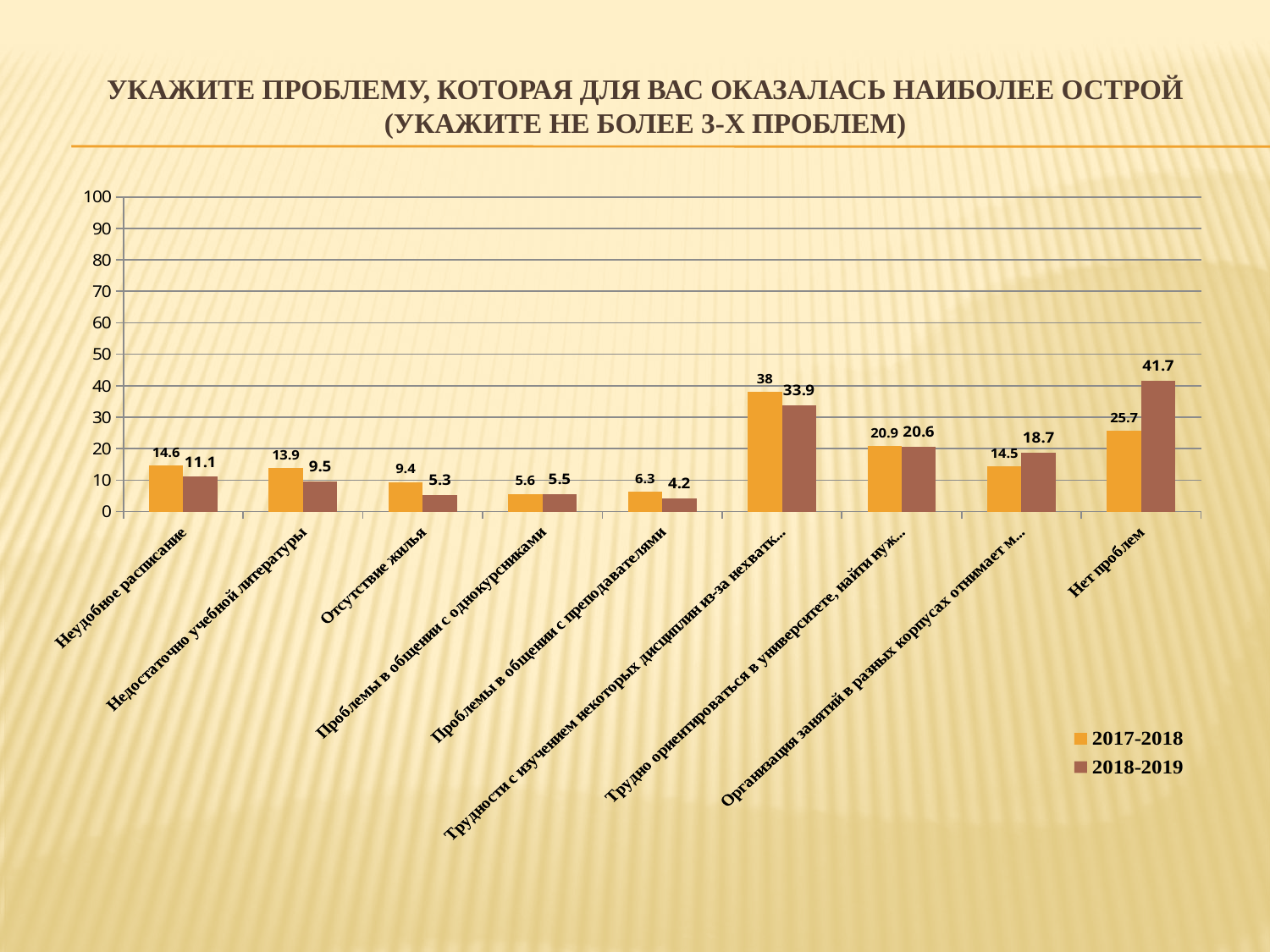
What is the difference between the 2017-2018 and 2018-2019 values for "Неудобное расписание"? 3.5 Which is larger for "Организация занятий в разных корпусах отнимает м...": the 2017-2018 value or the 2018-2019 value? 2018-2019 What is the difference between the 2018-2019 and 2017-2018 values for "Нет проблем"? 16 What kind of chart is shown on the slide? bar chart Which category has the lowest value in the 2018-2019 series? Проблемы в общении с преподавателями How many categories are shown on the x axis of the chart? 9 What is the value for "Отсутствие жилья" in the 2018-2019 series? 5.3 How many series does the legend list? 2 Is the 2017-2018 value for "Недостаточно учебной литературы" greater or less than 20? less What is the value for "Неудобное расписание" in the 2017-2018 series? 14.6 Which category has the highest value in the 2017-2018 series? Трудности с изучением некоторых дисциплин из-за нехватк... What is the value for "Нет проблем" in the 2018-2019 series? 41.7